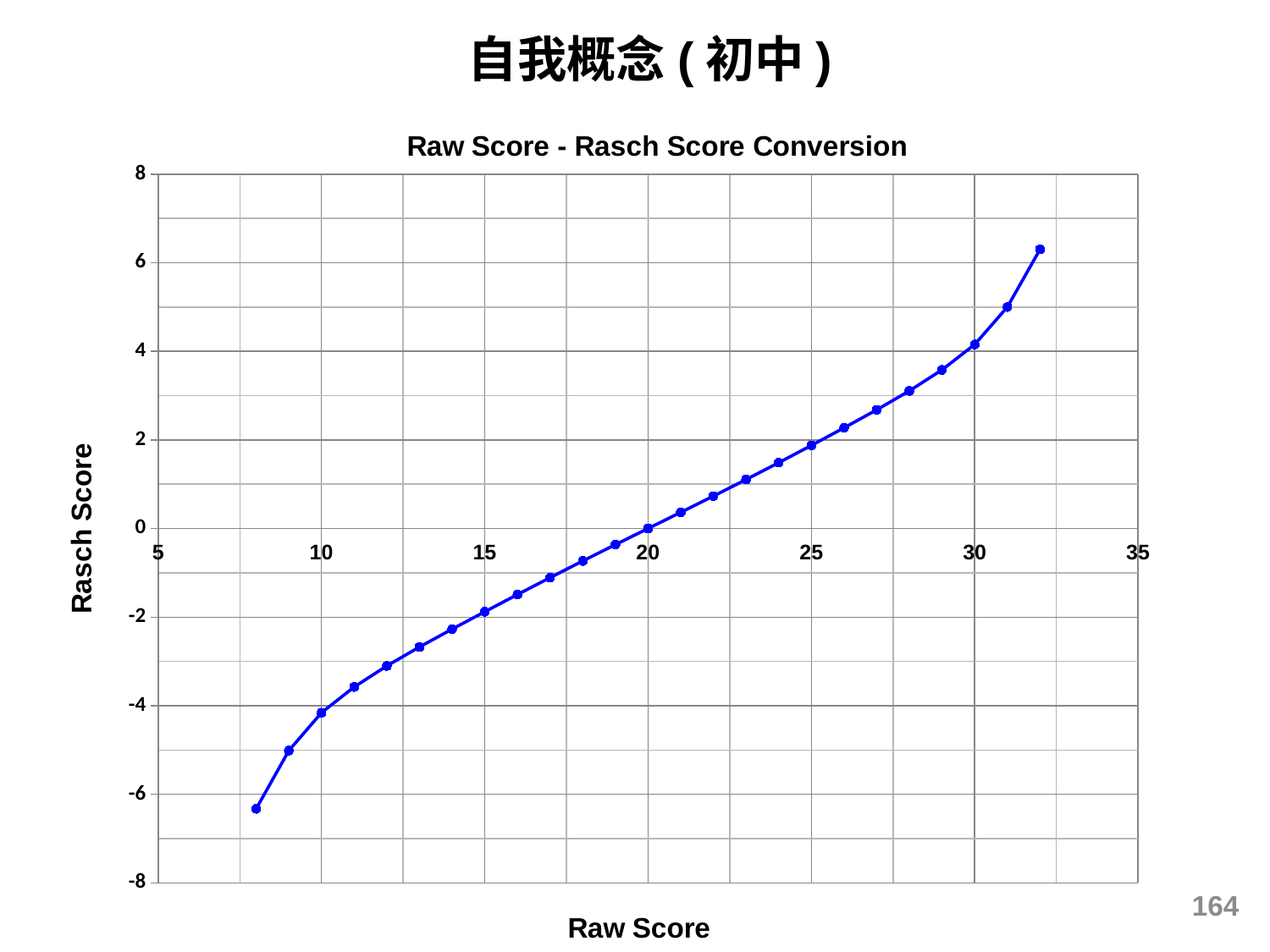
Do the Rasch Score values rise or fall as the Raw Score increases? Rise What is the Rasch Score at a Raw Score of 20? 0 At which Raw Score is the Rasch Score highest? 32 What is the title of the chart? Raw Score - Rasch Score Conversion How many data points are plotted on the line? 25 Which has the larger Rasch Score, a Raw Score of 24 or a Raw Score of 14? 24 Is the Rasch Score at a Raw Score of 12 greater or less than -2? less What is the label of the vertical axis? Rasch Score Is the Rasch Score at a Raw Score of 32 greater or less than 6? greater At which Raw Score is the Rasch Score lowest? 8 What kind of chart is shown on the slide? Line chart Is the Rasch Score at a Raw Score of 8 greater or less than -6? less